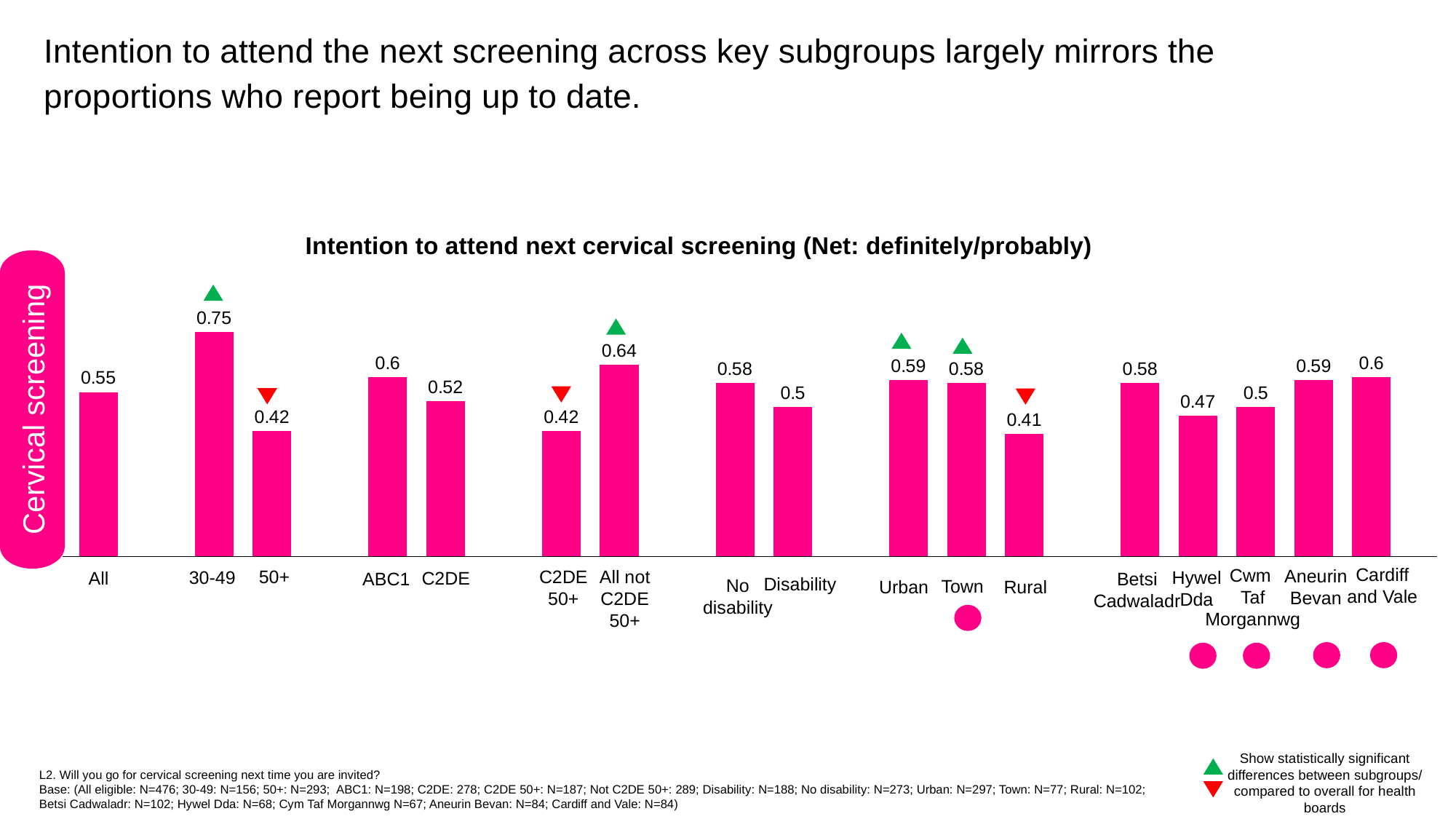
What kind of chart is shown? Bar chart Which is larger, the value for ABC1 or the value for C2DE? ABC1 What is the difference between the values for 30-49 and 50+? 0.33 What is the difference between the values for No disability and Disability? 0.08 What is the value for Rural? 0.41 How many bars are plotted in the chart? 17 What is the title of the chart? Intention to attend next cervical screening (Net: definitely/probably) What is the value for Hywel Dda? 0.47 Which category has the lowest value? Rural What is the value for the 30-49 group? 0.75 What is the value for All not C2DE 50+? 0.64 Which category has the highest value? 30-49